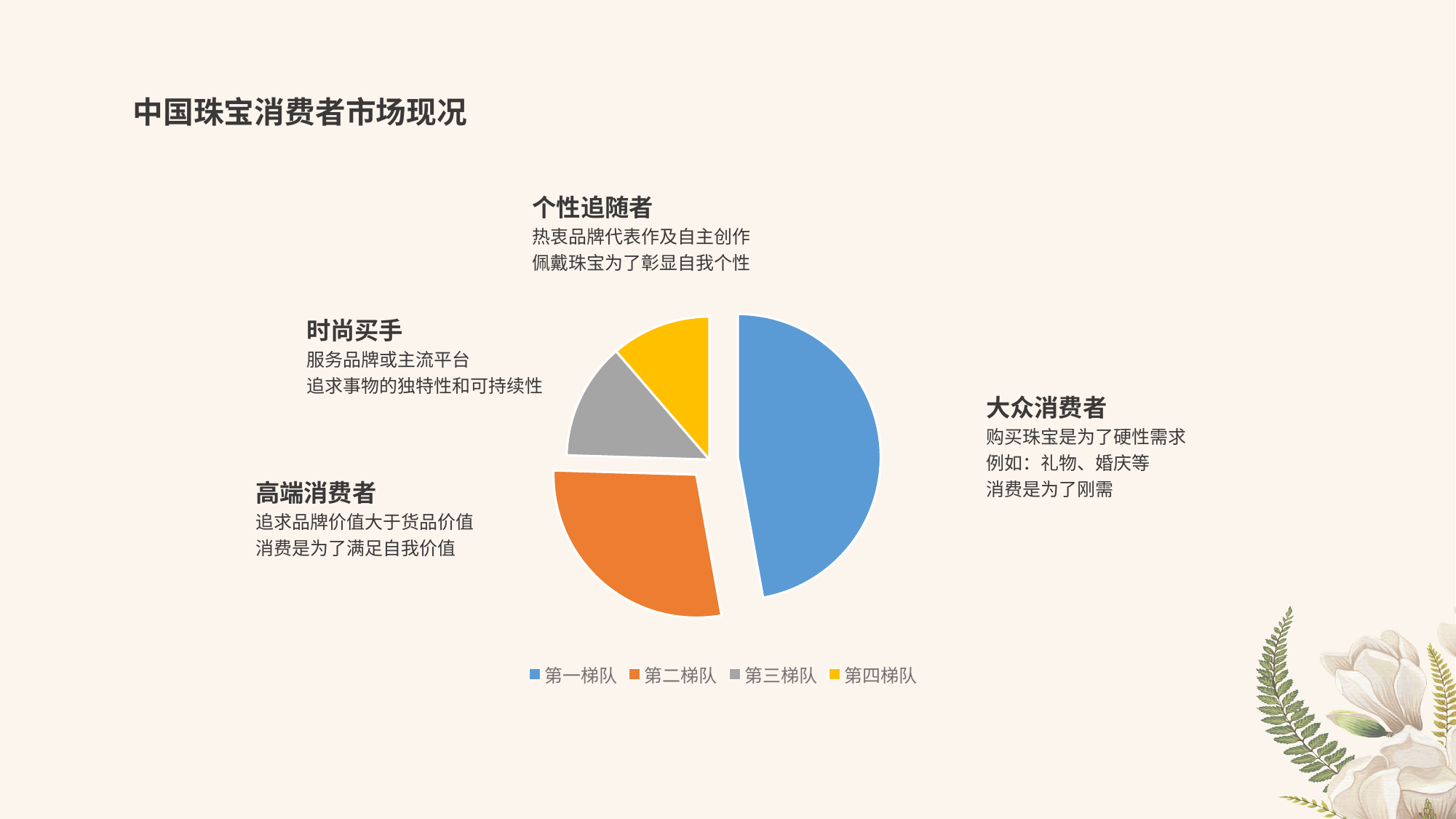
Which slice is larger, 第二梯队 or 第三梯队? 第二梯队 Which slice is larger, 第一梯队 or 第二梯队? 第一梯队 Which slice is larger, 第一梯队 or 第四梯队? 第一梯队 What kind of chart is shown on the slide? pie chart How many entries does the legend of the pie chart list? 4 How many slices does the pie chart have? 4 Which category has the largest slice in the pie chart? 第一梯队 What is the title of the slide containing the pie chart? 中国珠宝消费者市场现况 What colour is the 第一梯队 slice in the pie chart? blue